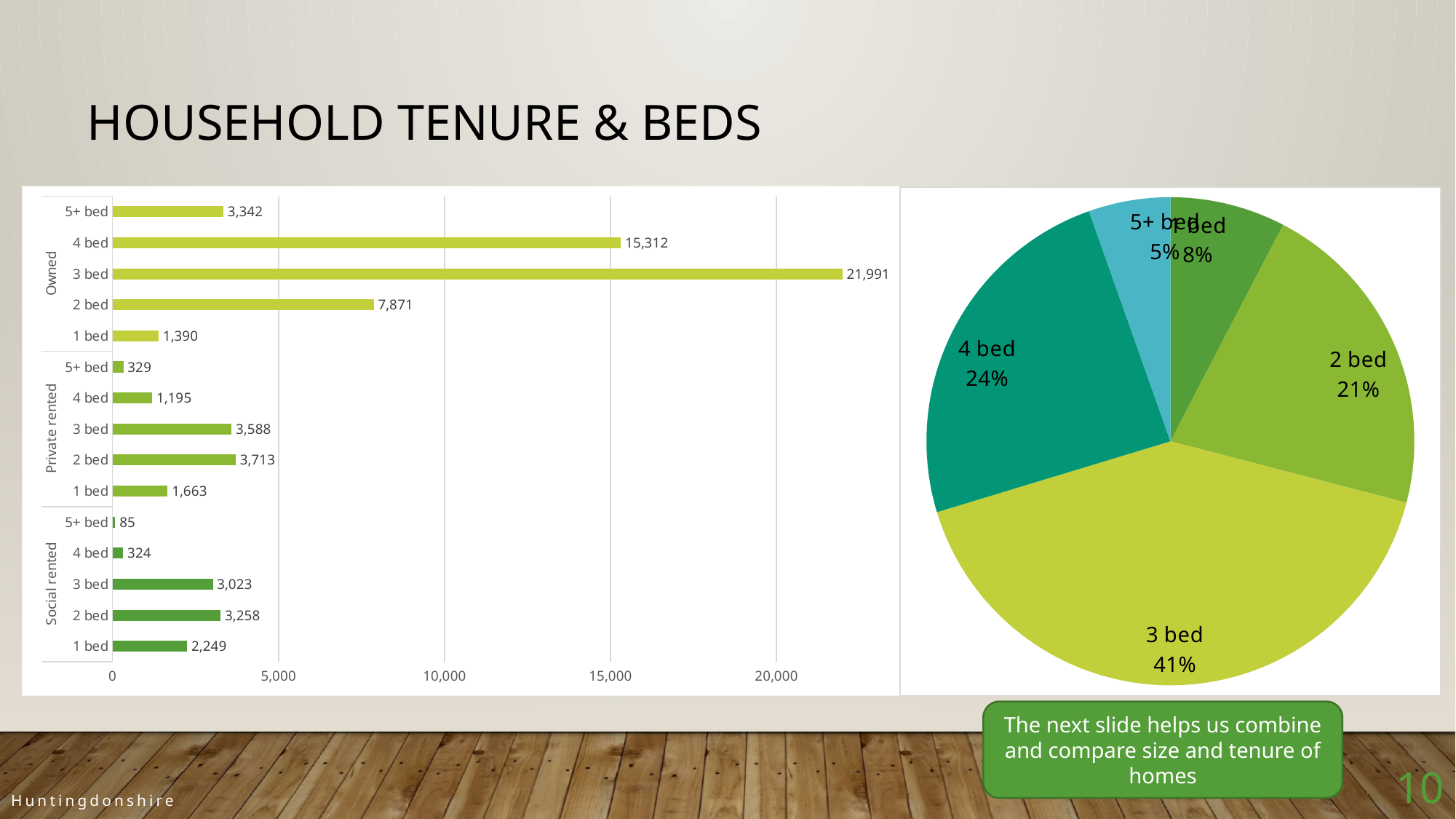
In the bar chart on the left, which bar has the lowest value? Social rented, 5+ bed In the pie chart on the right, how many slices are there? 5 In the bar chart on the left, how many bars are plotted in total? 15 What kind of chart is shown on the left of the slide? Bar chart In the bar chart on the left, what is the value for 5+ bed homes in the Social rented group? 85 In the pie chart on the right, what share do 3 bed homes have? 41% In the bar chart on the left, what is the difference between the Owned 4 bed value and the Owned 2 bed value? 7,441 In the pie chart on the right, which category has the largest slice? 3 bed In the bar chart on the left, which bar has the highest value? Owned, 3 bed In the bar chart on the left, what is the value for 3 bed homes in the Owned group? 21,991 In the bar chart on the left, what is the value for 2 bed homes in the Private rented group? 3,713 In the bar chart on the left, which is larger: 3 bed in Private rented or 3 bed in Social rented? 3 bed in Private rented